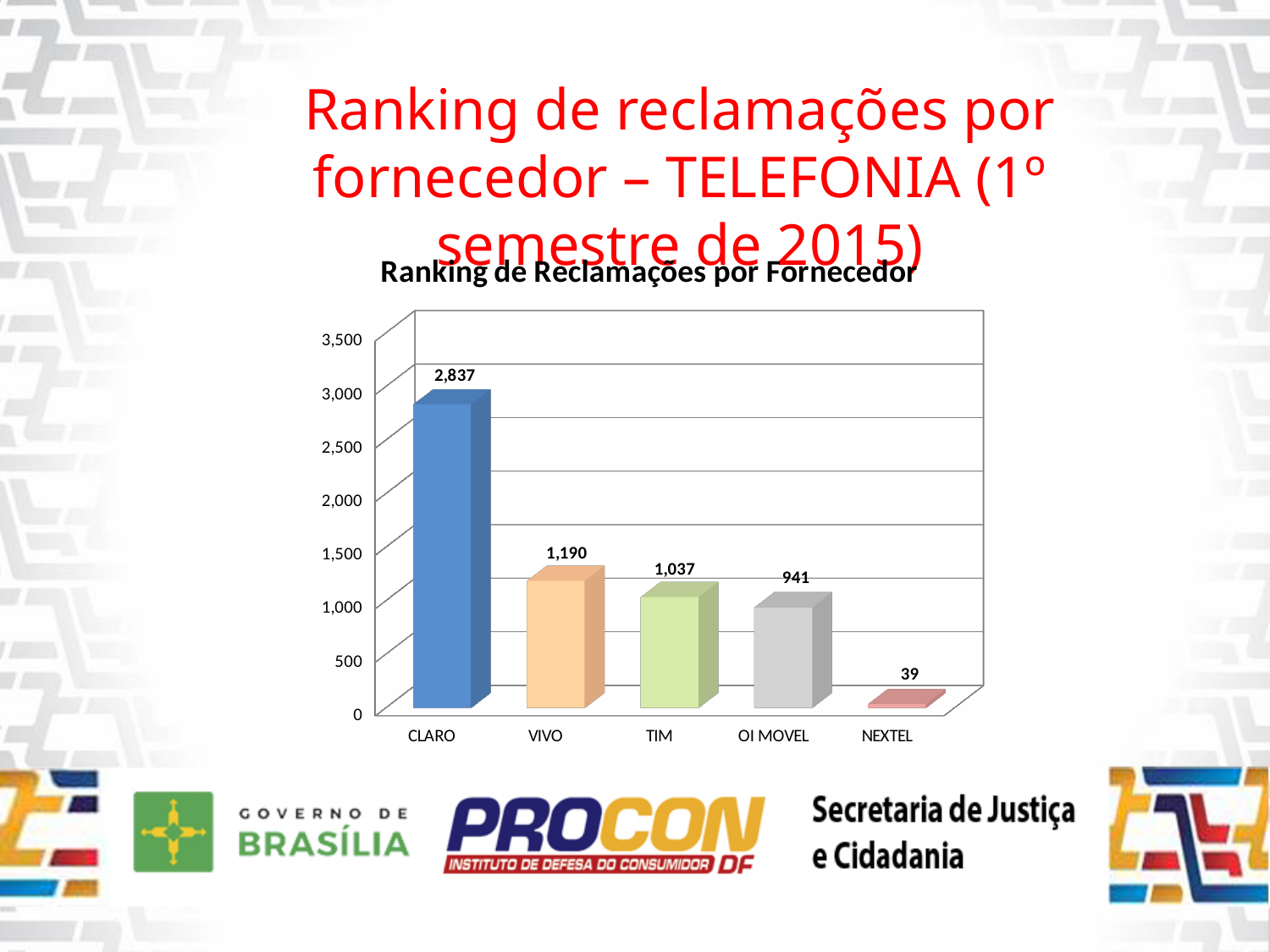
Which category has the lowest value? NEXTEL What is the value for VIVO? 1,190 What is the difference between the values for CLARO and VIVO? 1,647 What is the title of the chart? Ranking de Reclamações por Fornecedor What is the value for CLARO? 2,837 What is the value for NEXTEL? 39 Which category has the highest value? CLARO What kind of chart is shown on the slide? bar chart What is the value for TIM? 1,037 Which is larger, the value for TIM or the value for OI MOVEL? TIM What is the value for OI MOVEL? 941 How many categories are shown on the x axis? 5